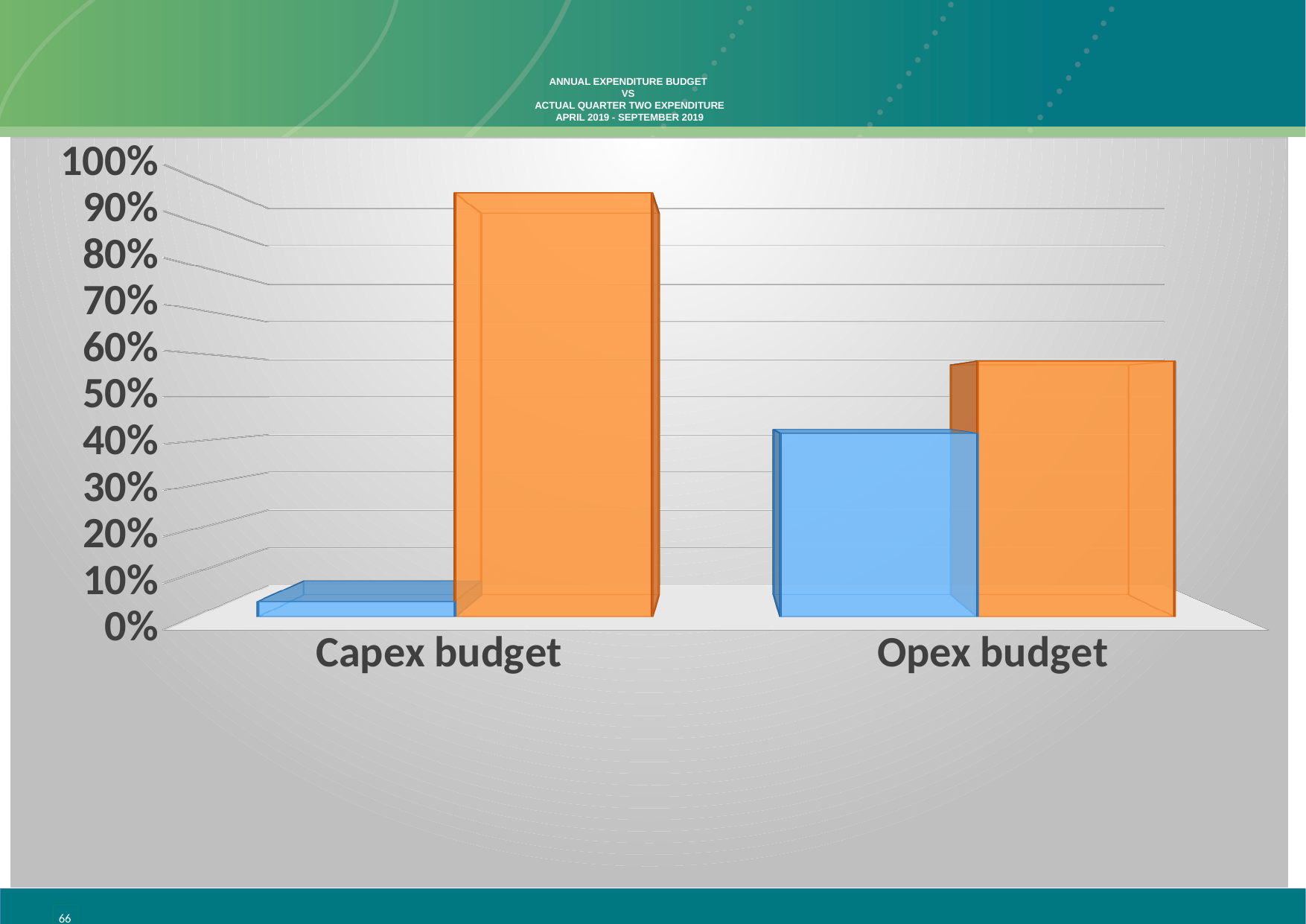
How many categories are shown on the x axis of the chart? 2 Which category has the taller orange bar, Capex budget or Opex budget? Capex budget Is the value of the blue bar for Opex budget greater or less than 30%? greater Is the value of the orange bar for Opex budget greater or less than 40%? greater Is the value of the blue bar for Opex budget greater or less than 50%? less Which bar is the shortest in the chart? the blue bar for Capex budget Which category has the taller blue bar, Capex budget or Opex budget? Opex budget Which bar is the tallest in the chart? the orange bar for Capex budget What kind of chart is shown on the slide? bar chart What are the two categories shown on the x axis? Capex budget and Opex budget